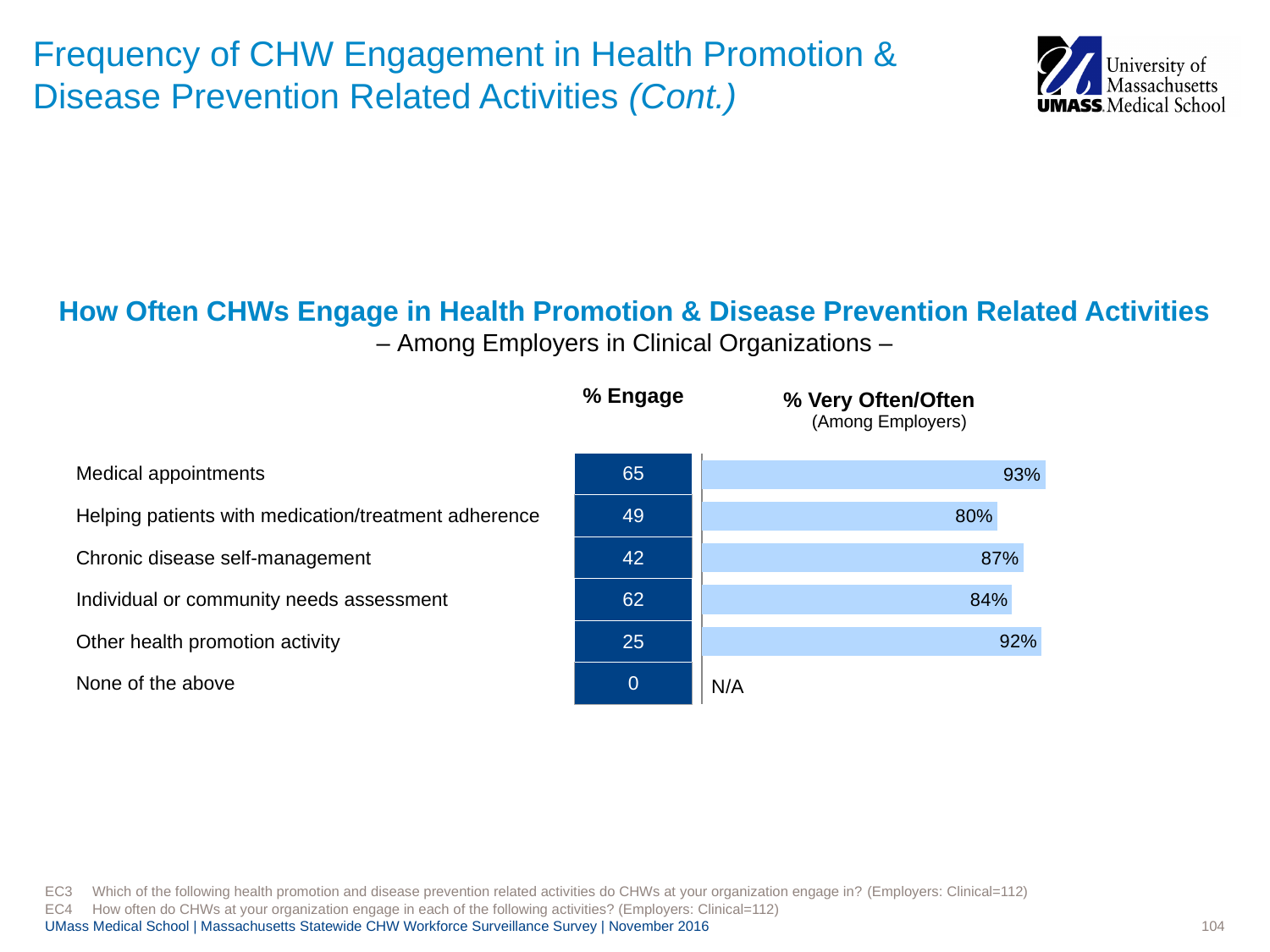
What is the % Engage value for Other health promotion activity? 25 What is the % Very Often/Often value for Chronic disease self-management? 87% Which has a larger % Very Often/Often value, Individual or community needs assessment or Other health promotion activity? Other health promotion activity Among the activities with a percentage shown, which has the lowest % Very Often/Often value? Helping patients with medication/treatment adherence What is the difference between the % Very Often/Often values for Medical appointments and Helping patients with medication/treatment adherence? 13% What is the % Engage value for Individual or community needs assessment? 62 What is the difference between the % Engage values for Medical appointments and Chronic disease self-management? 23 Which activity has the highest % Engage value? Medical appointments What type of chart is used to show the % Very Often/Often values? Bar chart Which activity has the highest % Very Often/Often value? Medical appointments How many activity categories are listed in the chart? 6 What is the % Very Often/Often value for Medical appointments? 93%